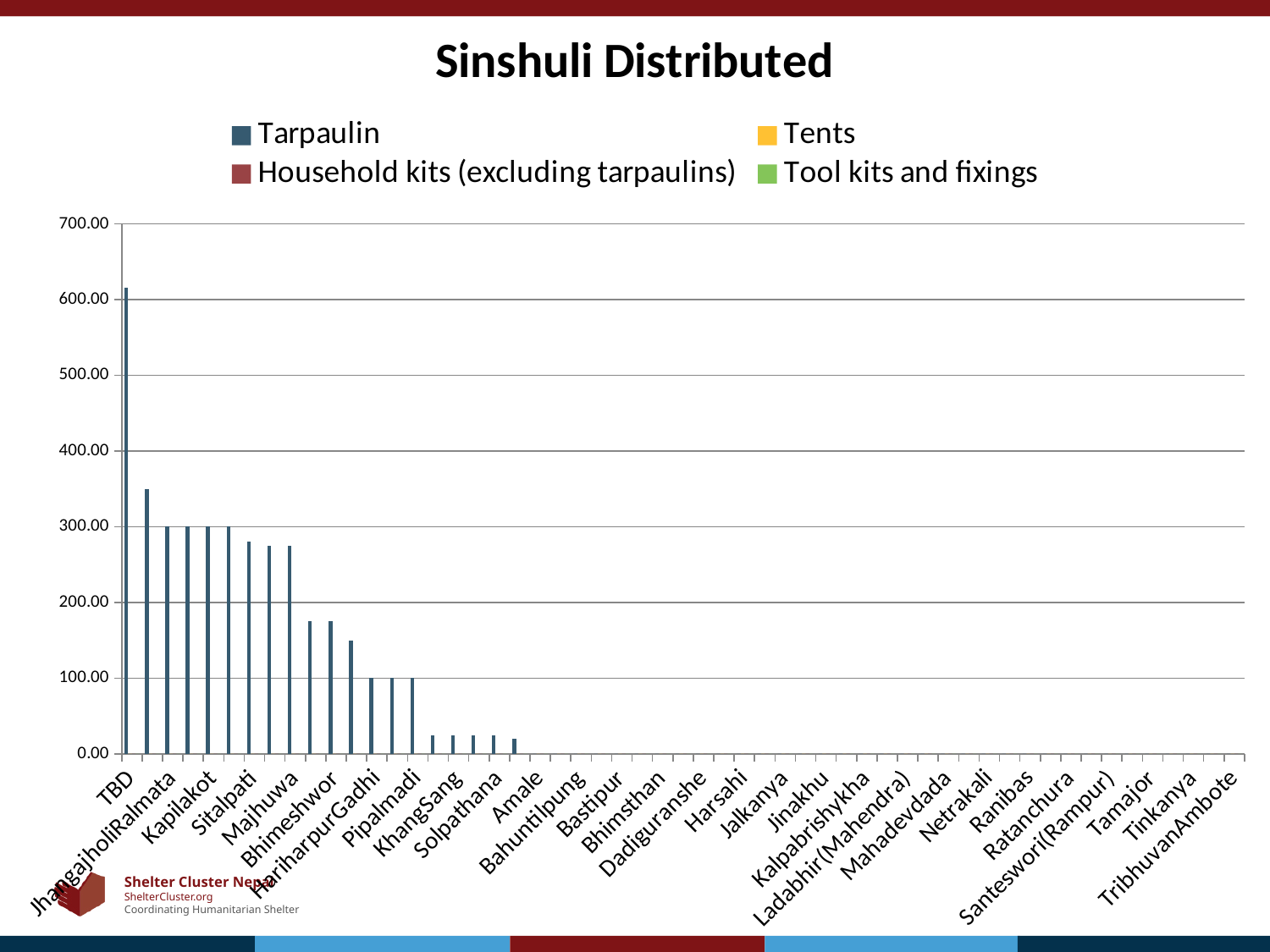
Do the Tarpaulin values rise or fall moving from left to right along the x axis? fall Which has the larger Tarpaulin value, Sitalpati or Bhimeshwor? Sitalpati Which category has the highest Tarpaulin value? TBD Is the Tarpaulin value for Sitalpati greater or less than 300? less What is the title of the chart? Sinshuli Distributed Which has the larger Tarpaulin value, TBD or Majhuwa? TBD Is the Tarpaulin value for Bhimeshwor greater or less than 200? less Is the Tarpaulin value for Bhimeshwor greater or less than 100? greater How many series does the legend list? 4 What kind of chart is shown on the slide? bar chart